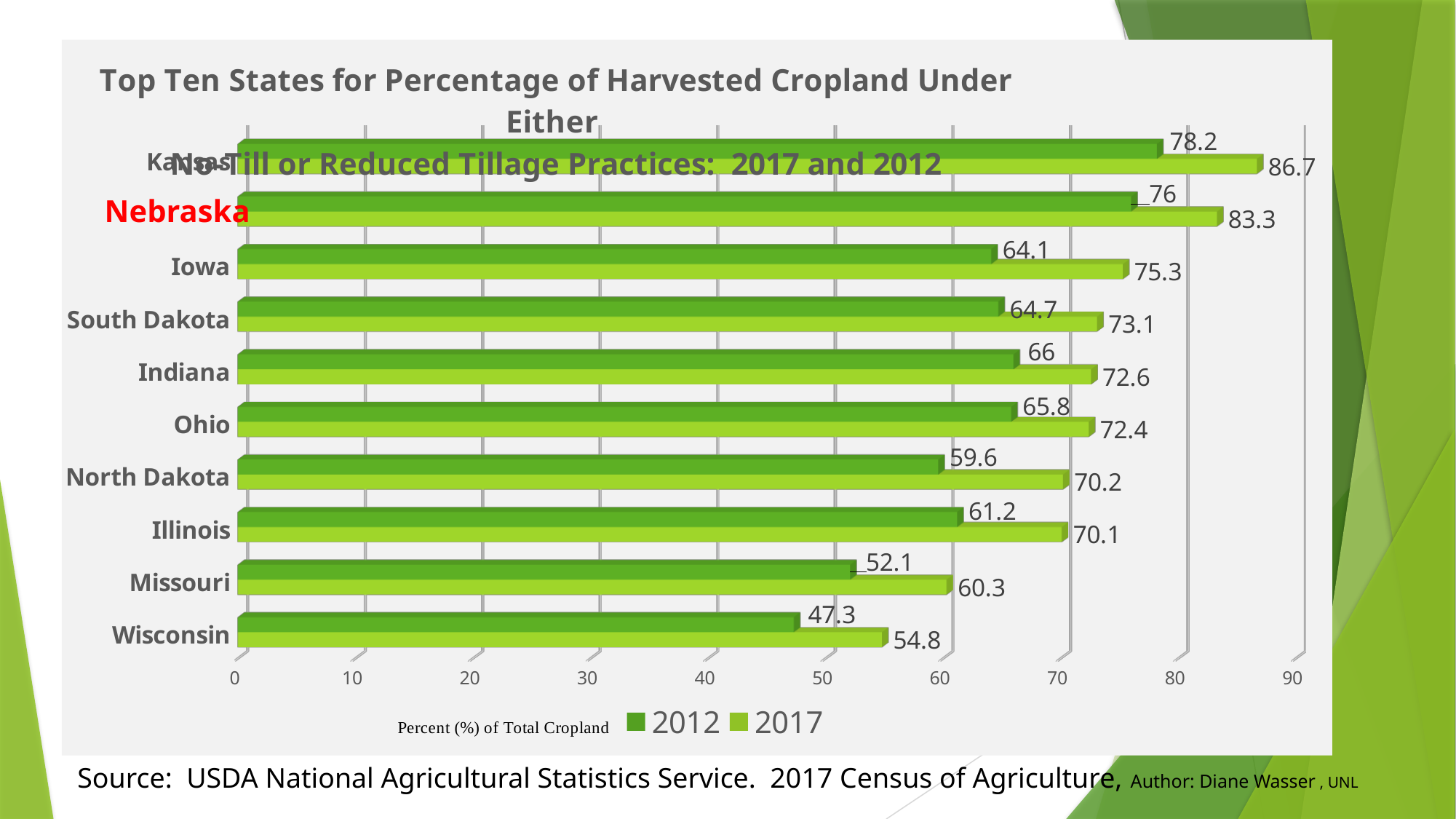
What is the difference between Missouri's 2017 and 2012 values? 8.2 How many states are shown in the chart? 10 Is North Dakota's 2012 value greater or less than 60? less What was Nebraska's value for 2017? 83.3 What is the difference between Nebraska's 2017 and 2012 values? 7.3 What was Nebraska's value for 2012? 76 How many series does the legend list? 2 What was Wisconsin's value for 2012? 47.3 Which is larger, Indiana's 2017 value or Ohio's 2017 value? Indiana's 2017 value Which state has the lowest value for 2017? Wisconsin What was Iowa's value for 2017? 75.3 What kind of chart is shown on the slide? bar chart